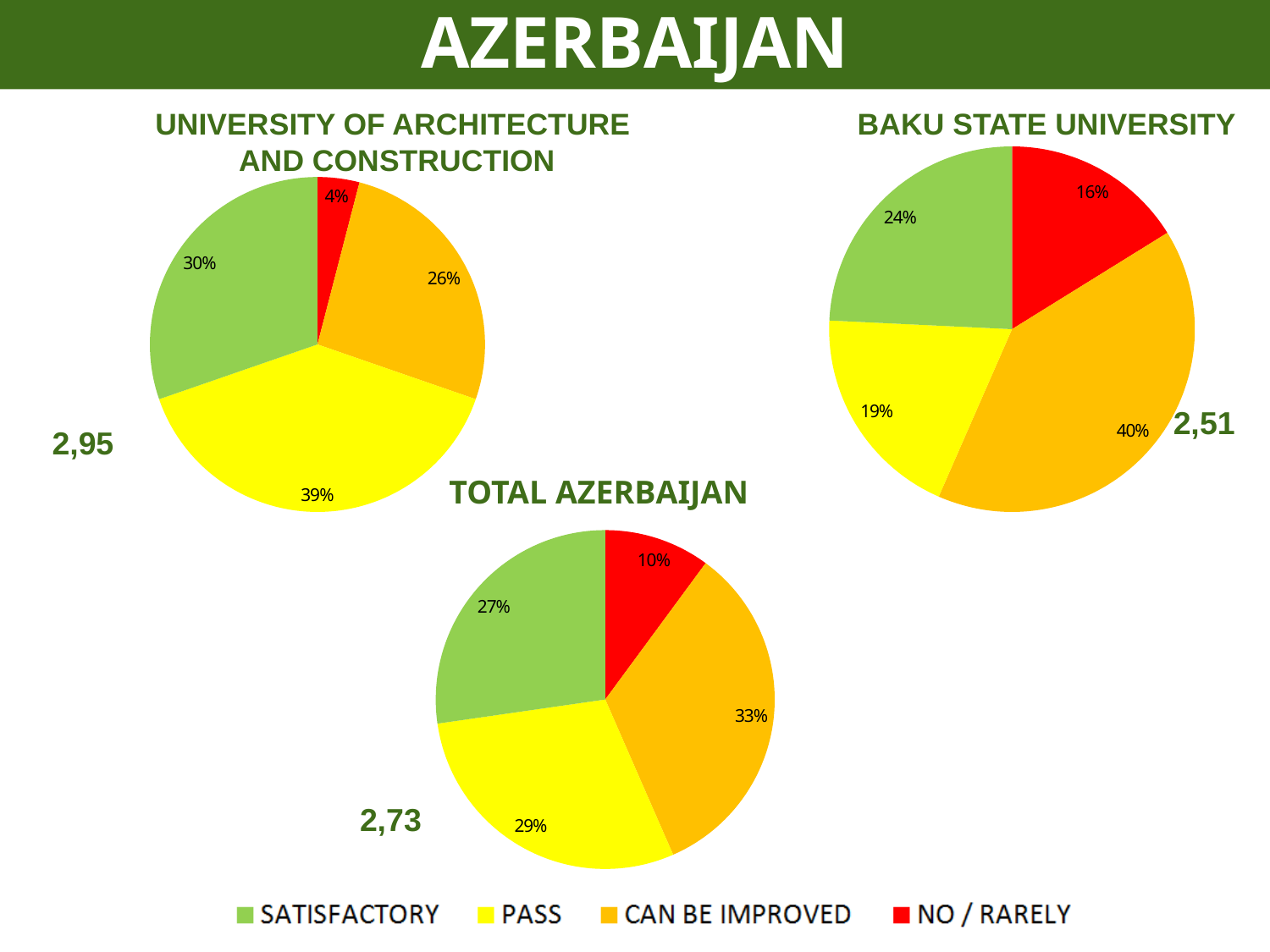
What type of chart is used for Total Azerbaijan? Pie chart In the Baku State University chart, which category has the largest slice? CAN BE IMPROVED In the Total Azerbaijan chart, which category has the largest slice? CAN BE IMPROVED What score is printed next to the Baku State University chart? 2,51 In the University of Architecture and Construction chart, which category has the smallest slice? NO / RARELY How many slices does the Baku State University pie chart have? 4 In the Total Azerbaijan chart, what is the difference in percentage points between the CAN BE IMPROVED slice and the PASS slice? 4 In the Baku State University chart, what share is labelled for the CAN BE IMPROVED slice? 40% In the Total Azerbaijan chart, what share is labelled for the NO / RARELY slice? 10% Is the SATISFACTORY share larger in the University of Architecture and Construction chart or in the Baku State University chart? University of Architecture and Construction In the University of Architecture and Construction chart, what share is labelled for the PASS slice? 39% How many categories does the legend at the bottom of the slide list? 4